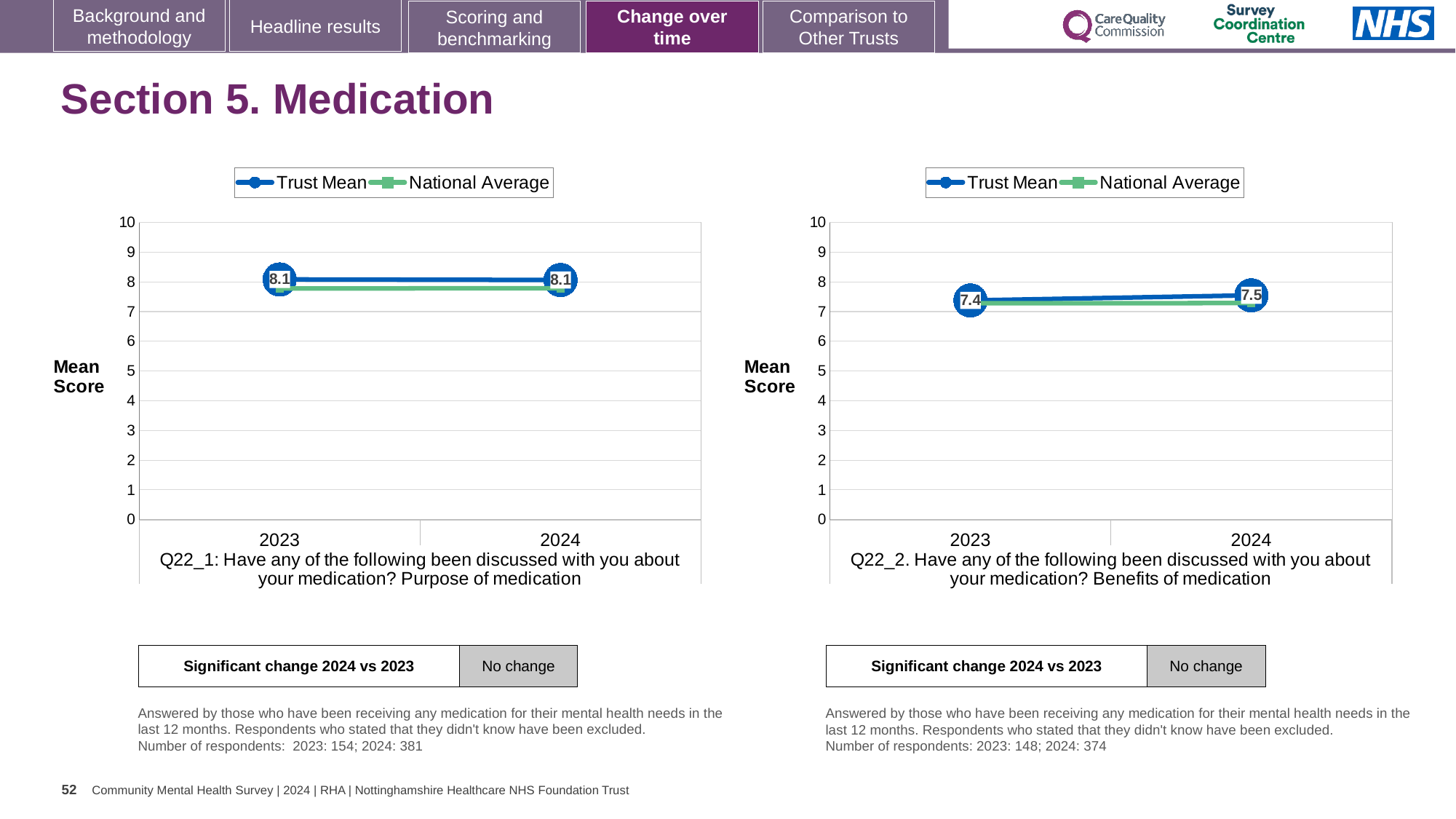
In the left chart (Q22_1: Purpose of medication), what is the Trust Mean score for 2024? 8.1 In the left chart (Q22_1: Purpose of medication), does the Trust Mean rise, fall or stay the same from 2023 to 2024? stays the same In the left chart (Q22_1: Purpose of medication), what is the Trust Mean score for 2023? 8.1 In the right chart (Q22_2: Benefits of medication), what is the Trust Mean score for 2023? 7.4 How many years are shown on the x axis of the left chart (Q22_1: Purpose of medication)? 2 In the right chart (Q22_2: Benefits of medication), what is the difference between the Trust Mean scores for 2024 and 2023? 0.1 What type of chart is the left chart (Q22_1: Purpose of medication)? line chart In the right chart (Q22_2: Benefits of medication), is the National Average value for 2023 greater or less than 8? less How many series does the legend of the right chart (Q22_2: Benefits of medication) list? 2 In the right chart (Q22_2: Benefits of medication), which year has the higher Trust Mean score, 2023 or 2024? 2024 In the left chart (Q22_1: Purpose of medication), is the National Average value for 2024 greater or less than 8? less In the right chart (Q22_2: Benefits of medication), what is the Trust Mean score for 2024? 7.5